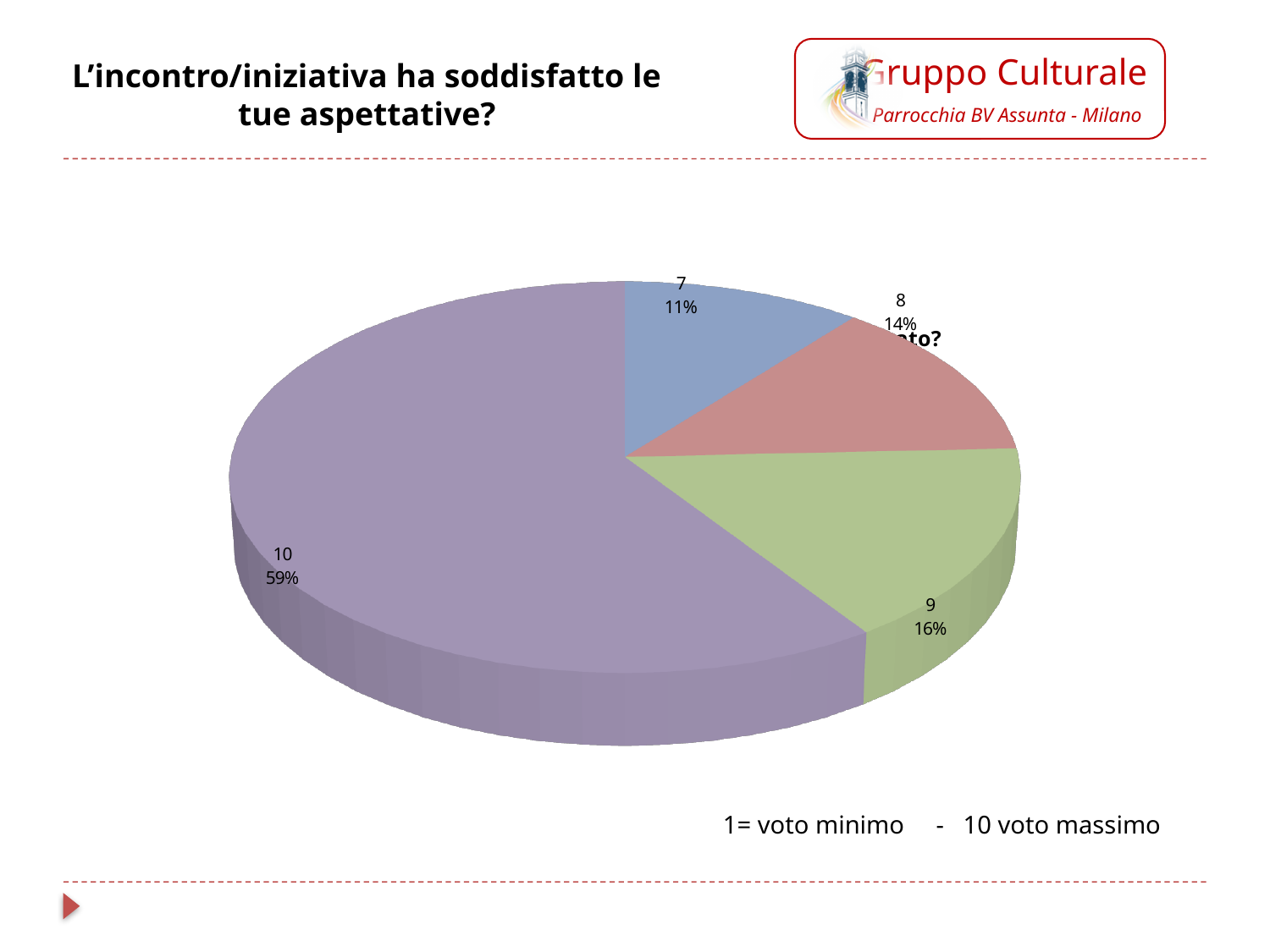
What is the combined share of the slices labelled 7 and 8? 25% Which slice of the pie chart is the smallest? 7 What percentage of the pie does the slice labelled 10 represent? 59% What colour is the slice labelled 10 in the pie chart? purple What is the difference in percentage points between the slice labelled 10 and the slice labelled 9? 43 How many slices does the pie chart have? 4 What kind of chart is shown on the slide? pie chart Which slice is larger, the one labelled 8 or the one labelled 9? 9 What percentage of the pie does the slice labelled 9 represent? 16% Which slice of the pie chart is the largest? 10 What percentage of the pie does the slice labelled 7 represent? 11% What percentage of the pie does the slice labelled 8 represent? 14%